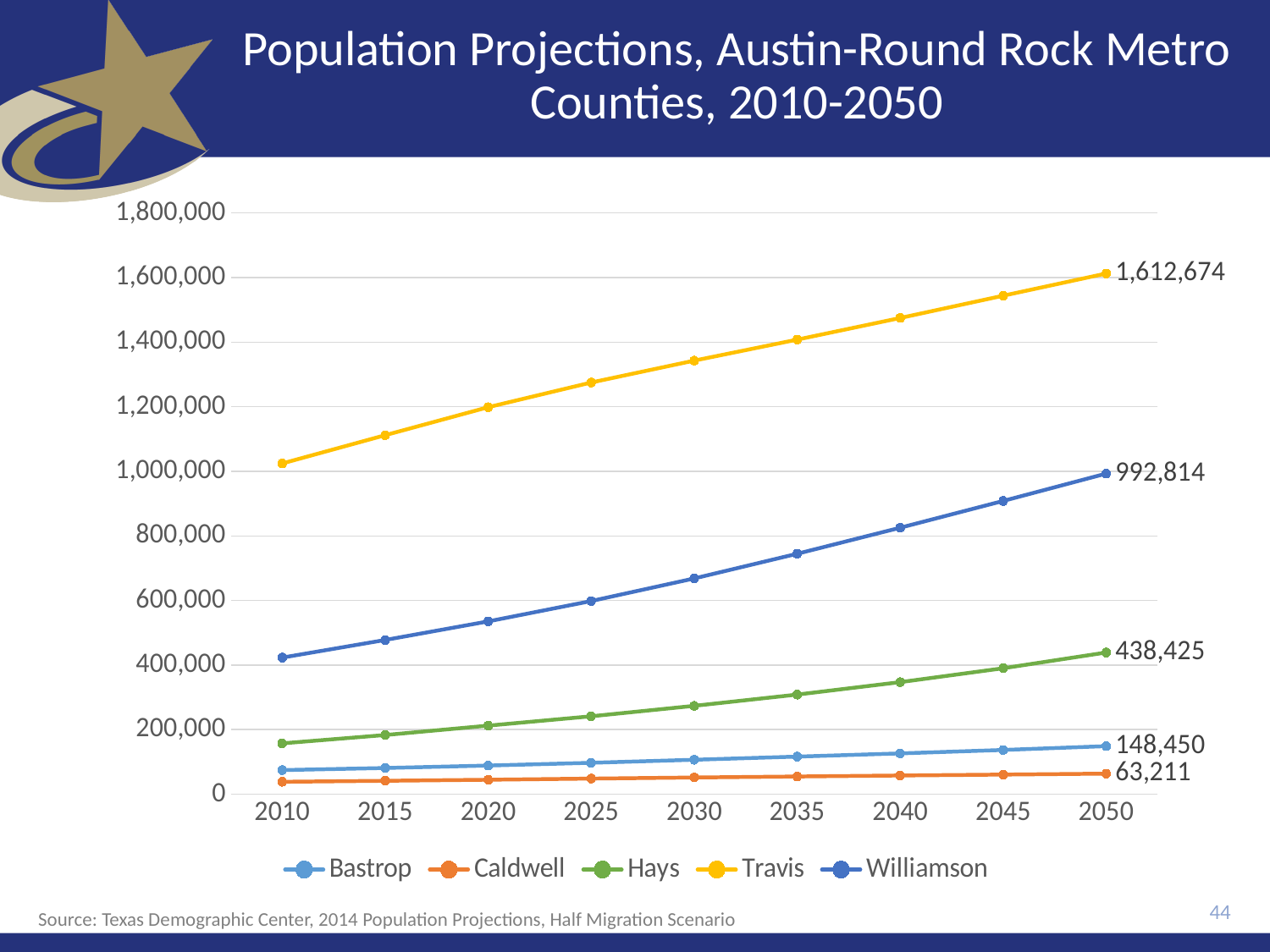
What is the projected population of Travis County in 2050? 1,612,674 What is the difference between the 2050 projected populations of Travis and Williamson counties? 619,860 Which county has the lowest projected population in 2050? Caldwell Which county has the highest projected population in 2050? Travis Which county has a larger projected population in 2050, Hays or Bastrop? Hays What is the projected population of Williamson County in 2050? 992,814 What kind of chart is shown on the slide? line chart What is the projected population of Hays County in 2050? 438,425 Is the projected population of Travis County in 2010 greater or less than 1,200,000? less How many series does the legend list? 5 Does the projected population of Williamson County rise or fall from 2010 to 2050? rise What is the projected population of Caldwell County in 2050? 63,211